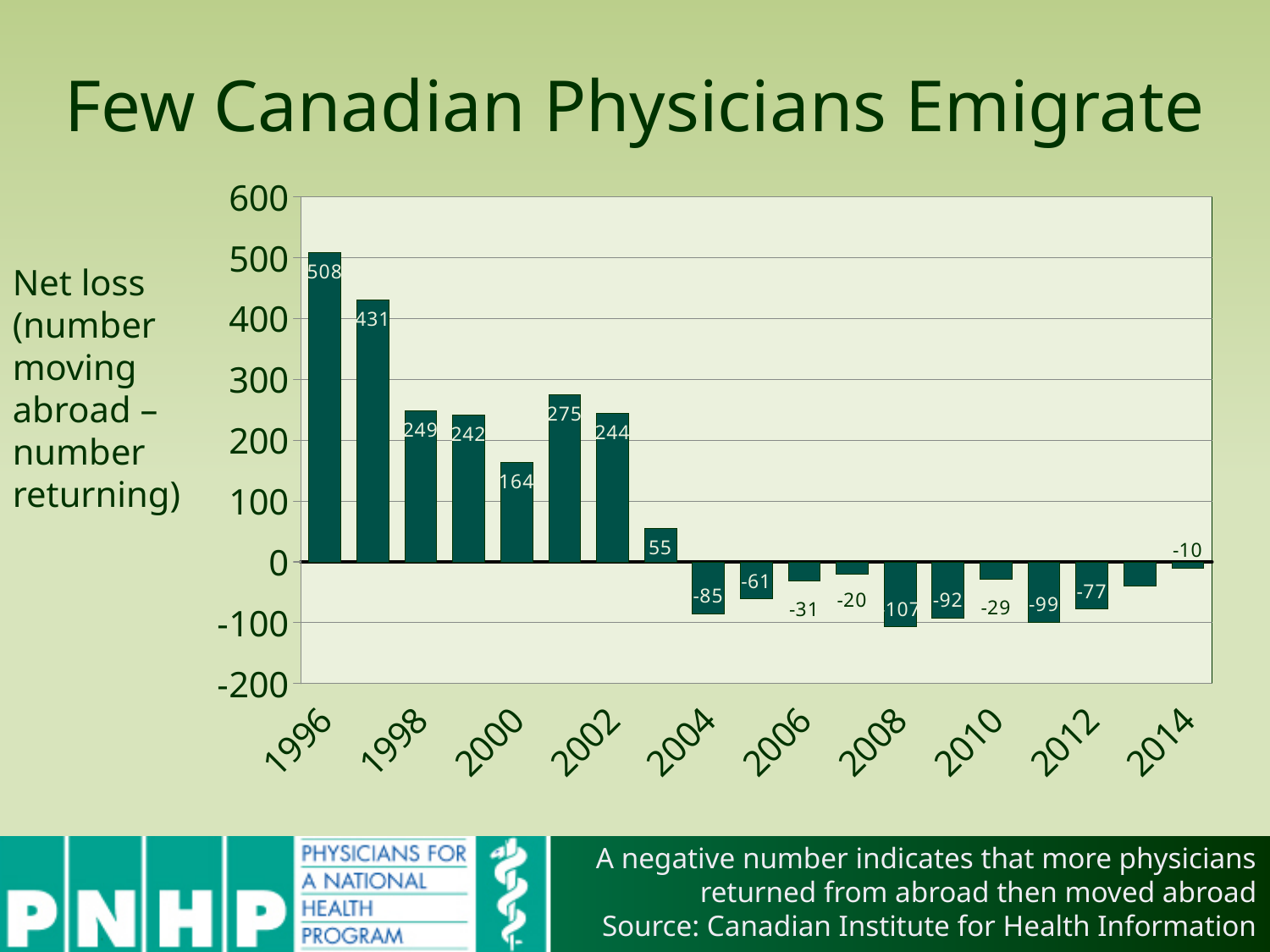
What is the net loss value for 1996? 508 Which year has the highest net loss value? 1996 How many bars (years) are plotted in the chart? 19 What is the value shown for 2014? -10 Which year has the lowest (most negative) value? 2008 What is the difference between the values for 1996 and 1997? 77 What kind of chart is shown on the slide? Bar chart What is the value shown for 2008? -107 What is the title of the slide? Few Canadian Physicians Emigrate Which year has the larger value, 2001 or 2002? 2001 Is the value for 2013 greater or less than 0? less What is the net loss value for 2000? 164